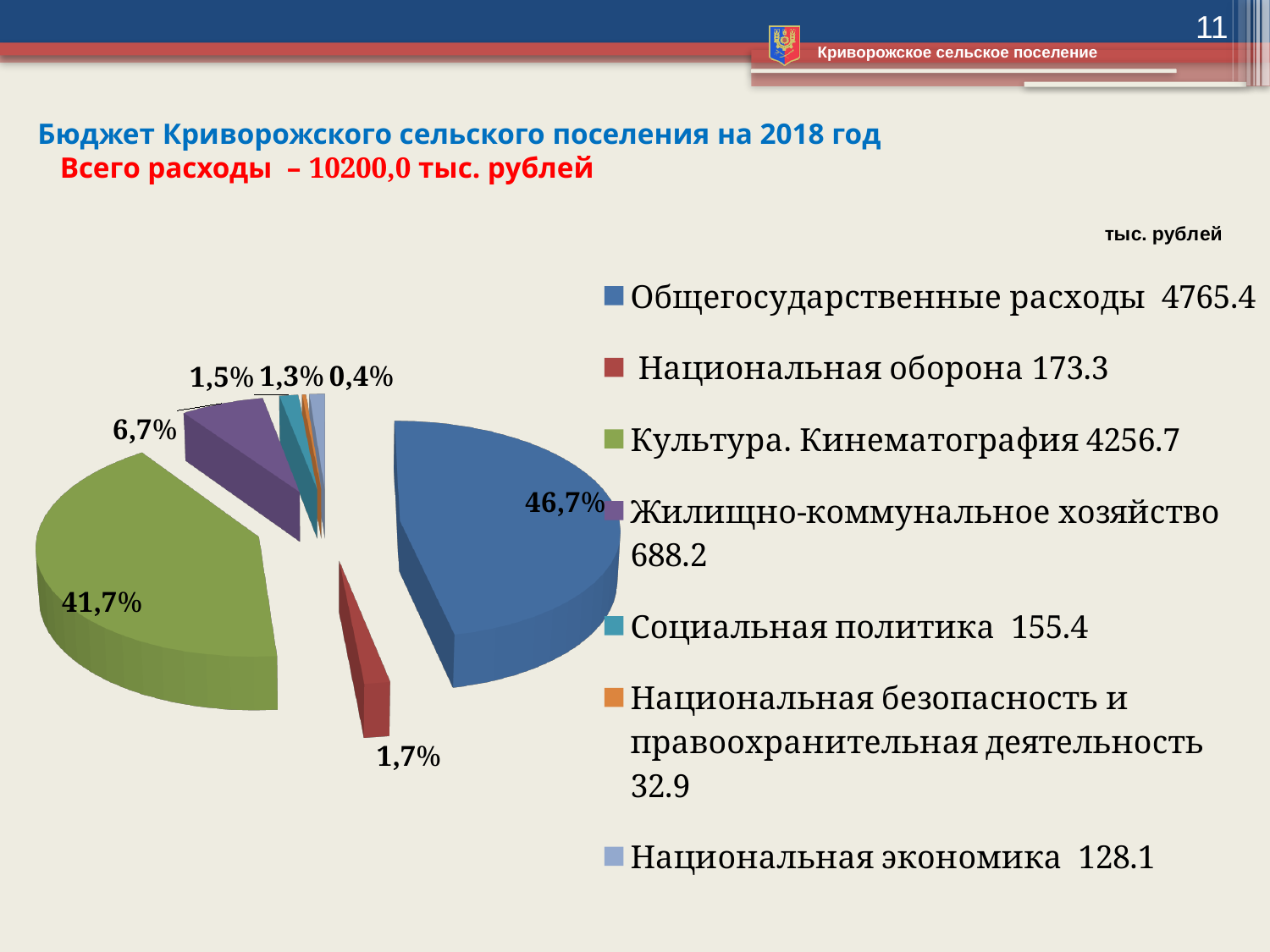
What is the value for Социальная политика in the legend? 155.4 What share of the pie does Жилищно-коммунальное хозяйство take? 6,7% What kind of chart is shown on the slide? Pie chart What is the difference between the values for Общегосударственные расходы and Культура. Кинематография? 508.7 What is the value for Общегосударственные расходы in the legend? 4765.4 Which category has the largest value in the pie chart? Общегосударственные расходы What share of the pie does Общегосударственные расходы take? 46,7% How many expenditure categories does the legend of the pie chart list? 7 What share of the pie does Культура. Кинематография take? 41,7% What is the value for Культура. Кинематография in the legend? 4256.7 Which is larger: Жилищно-коммунальное хозяйство or Национальная оборона? Жилищно-коммунальное хозяйство Which category has the smallest value in the pie chart? Национальная безопасность и правоохранительная деятельность